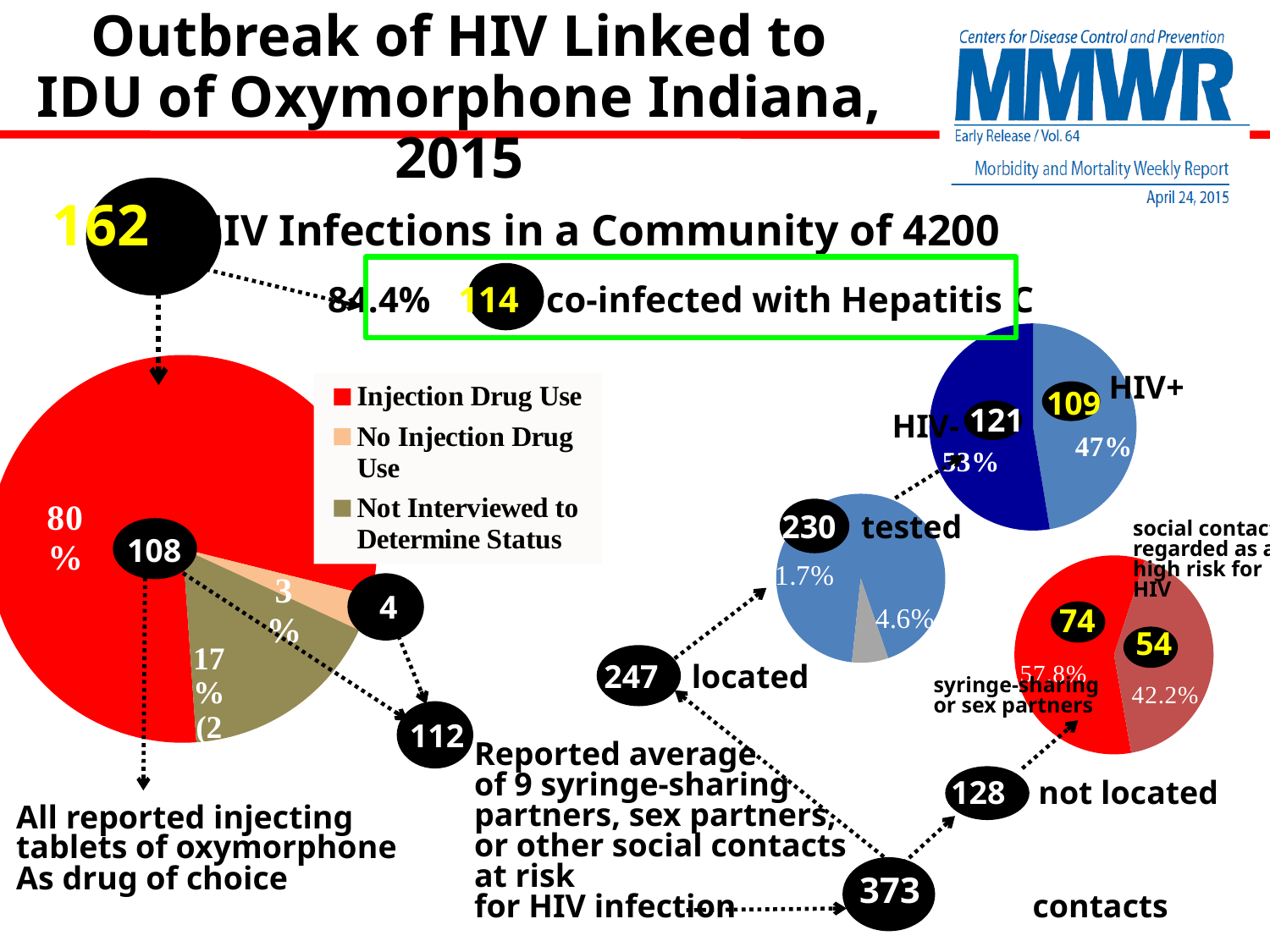
On the blue pie chart in the upper right, which slice is larger, HIV- or HIV+? HIV- On the red pie chart in the lower right, what percentage is shown for the larger slice (syringe-sharing or sex partners)? 57.8% On the large pie chart on the left, what percentage is shown for Injection Drug Use? 80% On the large pie chart on the left, what percentage is shown for No Injection Drug Use? 3% How many categories does the legend of the large pie chart on the left list? 3 On the large pie chart on the left, what percentage is shown for Not Interviewed to Determine Status? 17% On the blue pie chart in the upper right, what percentage is shown for HIV-? 53% On the red pie chart in the lower right, what is the difference in percentage points between the 57.8% slice and the 42.2% slice? 15.6 percentage points On the blue pie chart in the upper right, what percentage is shown for HIV+? 47% On the large pie chart on the left, which category has the largest slice? Injection Drug Use On the large pie chart on the left, which category has the smallest slice? No Injection Drug Use What kind of chart is the large red chart on the left of the slide? Pie chart